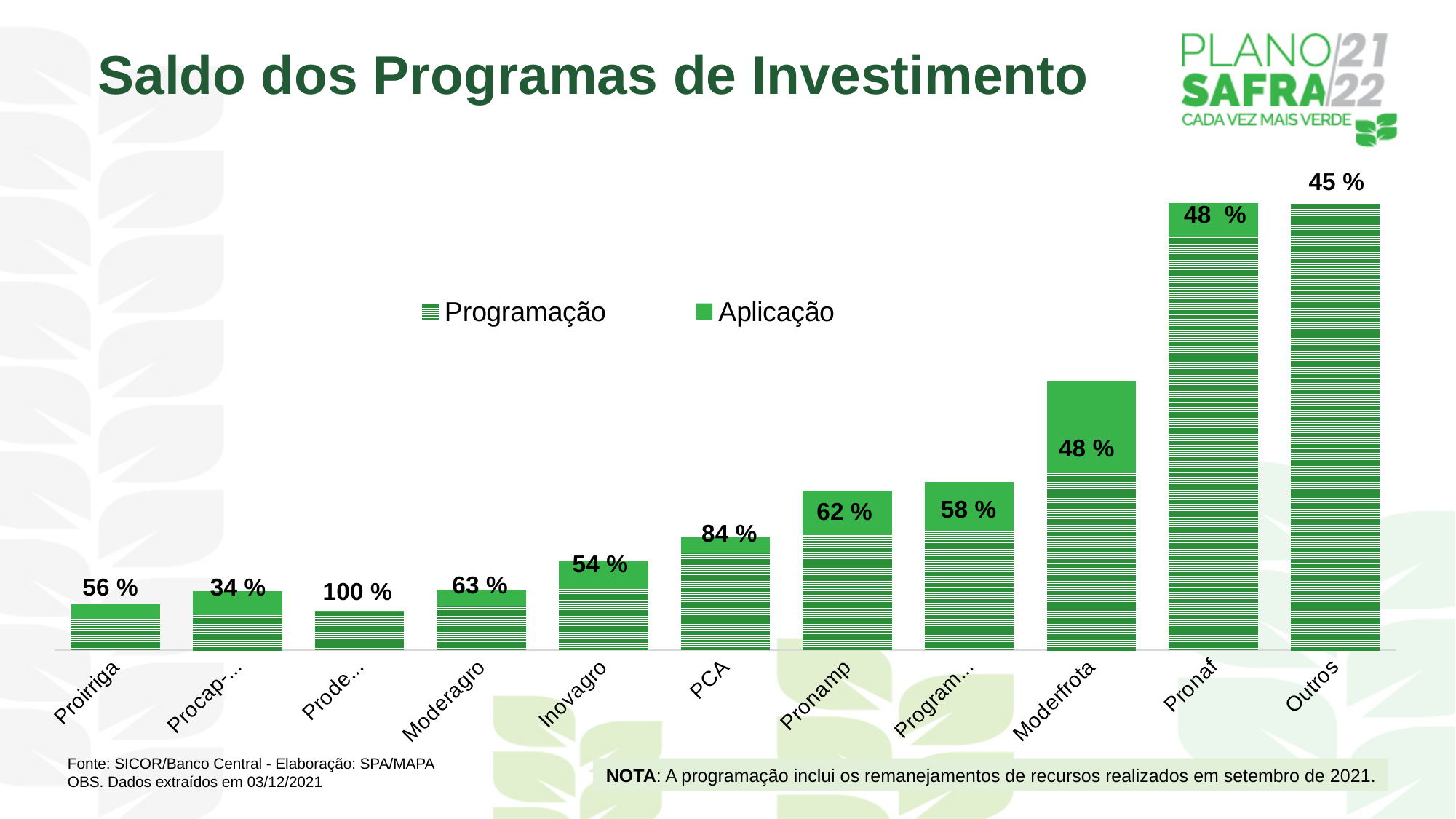
What percentage label is shown for Proirriga? 56 % Which bar is taller, Moderfrota or Pronamp? Moderfrota What is the title of the chart on the slide? Saldo dos Programas de Investimento How many program categories are shown on the x axis? 11 What percentage label is shown for Outros? 45 % How many series does the legend list? 2 What type of chart is shown on the slide? stacked bar chart Do the bar heights generally rise or fall from left to right along the x axis? rise What percentage label is shown for Moderfrota? 48 % Which category has the tallest bar? Outros What percentage label is shown for PCA? 84 % What are the two series named in the legend? Programação and Aplicação